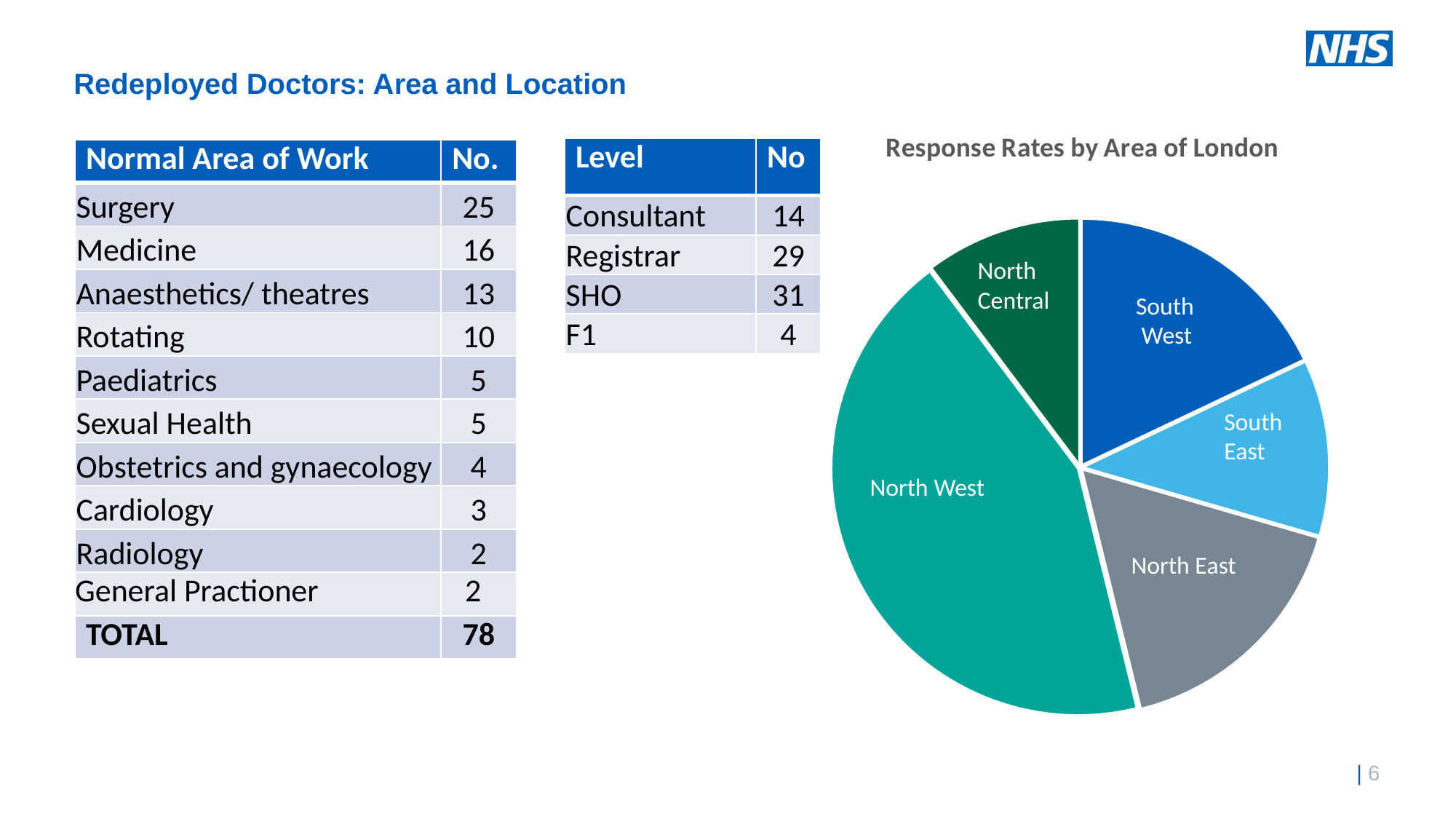
What is the title of the pie chart? Response Rates by Area of London In the pie chart, which slice is larger: North West or North East? North West How many slices does the pie chart have? 5 In the pie chart, which slice is larger: North East or North Central? North East Does the North West slice take up more or less than half of the pie chart? less What kind of chart is shown on the slide? pie chart In the pie chart, which slice is larger: South West or South East? South West Which slice of the pie chart is coloured grey? North East Which area of London has the largest slice in the pie chart? North West